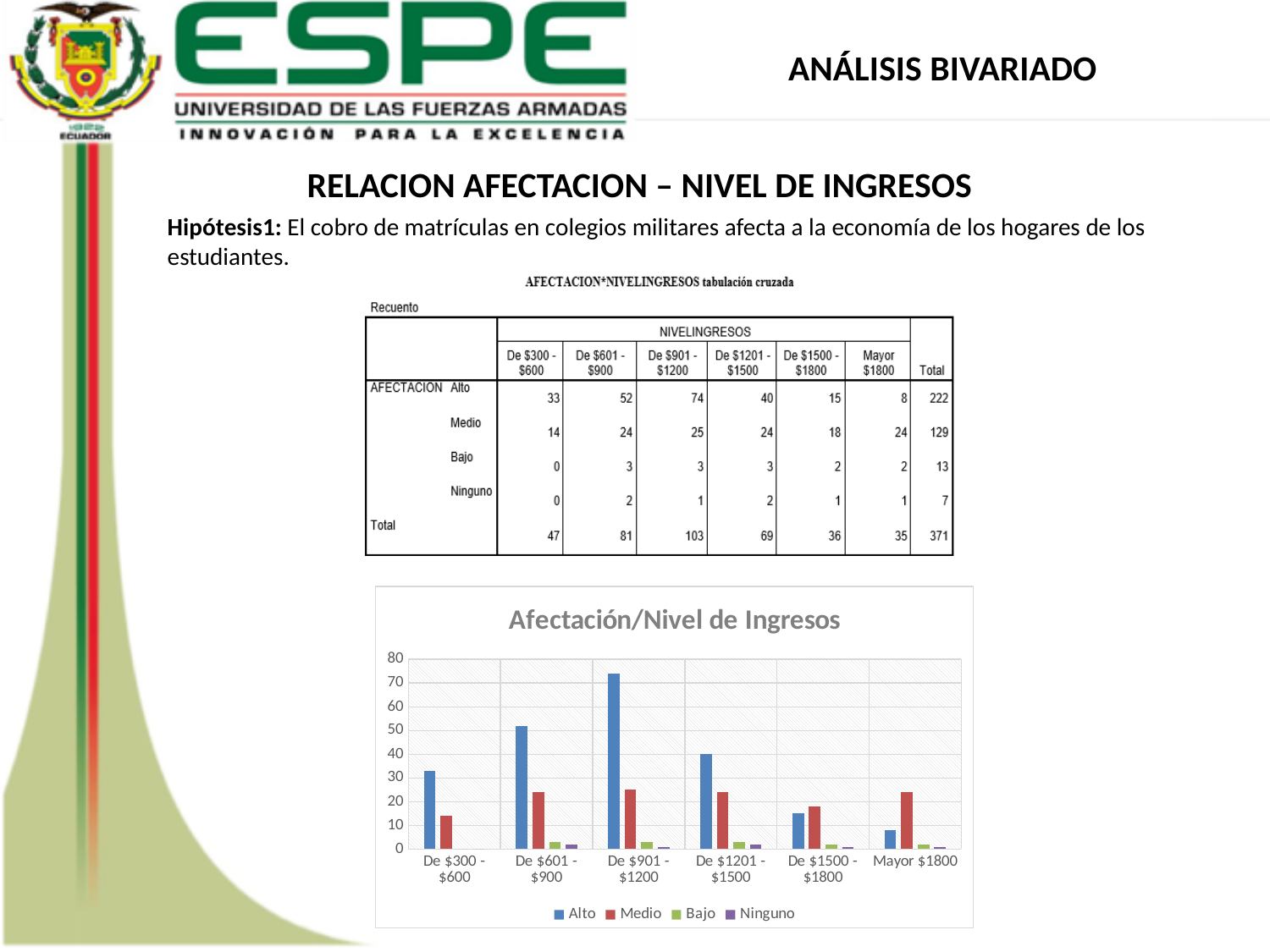
In the "Afectación/Nivel de Ingresos" chart, for Mayor $1800, which is larger: Alto or Medio? Medio How many series does the legend of the "Afectación/Nivel de Ingresos" chart list? 4 According to the table on the slide, what is the Alto count for De $901 - $1200? 74 In the "Afectación/Nivel de Ingresos" chart, which income category has the lowest Alto bar? Mayor $1800 What kind of chart is shown under the title "Afectación/Nivel de Ingresos"? bar chart In the "Afectación/Nivel de Ingresos" chart, which income category has the highest Alto bar? De $901 - $1200 What is the title of the bar chart on the slide? Afectación/Nivel de Ingresos According to the table on the slide, what is the difference between the Alto and Medio counts for De $901 - $1200? 49 In the "Afectación/Nivel de Ingresos" chart, is the Alto value for De $901 - $1200 greater or less than 70? greater In the "Afectación/Nivel de Ingresos" chart, is the Alto value for De $300 - $600 greater or less than 40? less How many income categories are shown on the x axis of the "Afectación/Nivel de Ingresos" chart? 6 In the "Afectación/Nivel de Ingresos" chart, do the Alto bars rise or fall from De $1201 - $1500 to Mayor $1800? fall